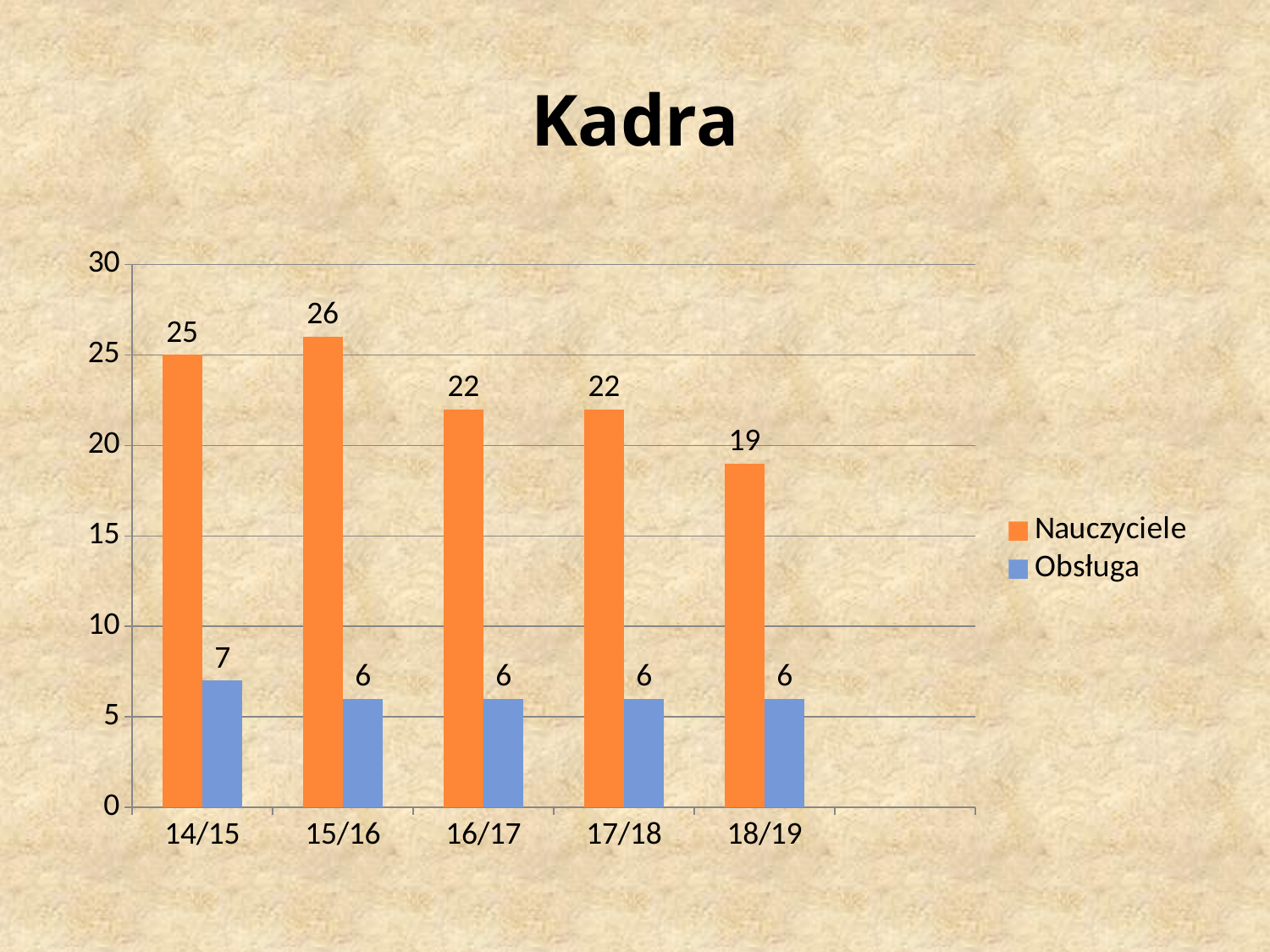
What is the value for Nauczyciele in 14/15? 25 Does the Nauczyciele value rise or fall from 15/16 to 18/19? fall What kind of chart is shown on the slide? bar chart Which is larger, the Nauczyciele value for 14/15 or for 16/17? 14/15 What is the difference between the Nauczyciele values for 15/16 and 18/19? 7 In which year is the Nauczyciele value lowest? 18/19 What is the title of the chart? Kadra How many years are shown on the x axis? 5 How many series does the legend list? 2 In which year is the Nauczyciele value highest? 15/16 What is the value for Obsługa in 14/15? 7 What is the value for Nauczyciele in 18/19? 19